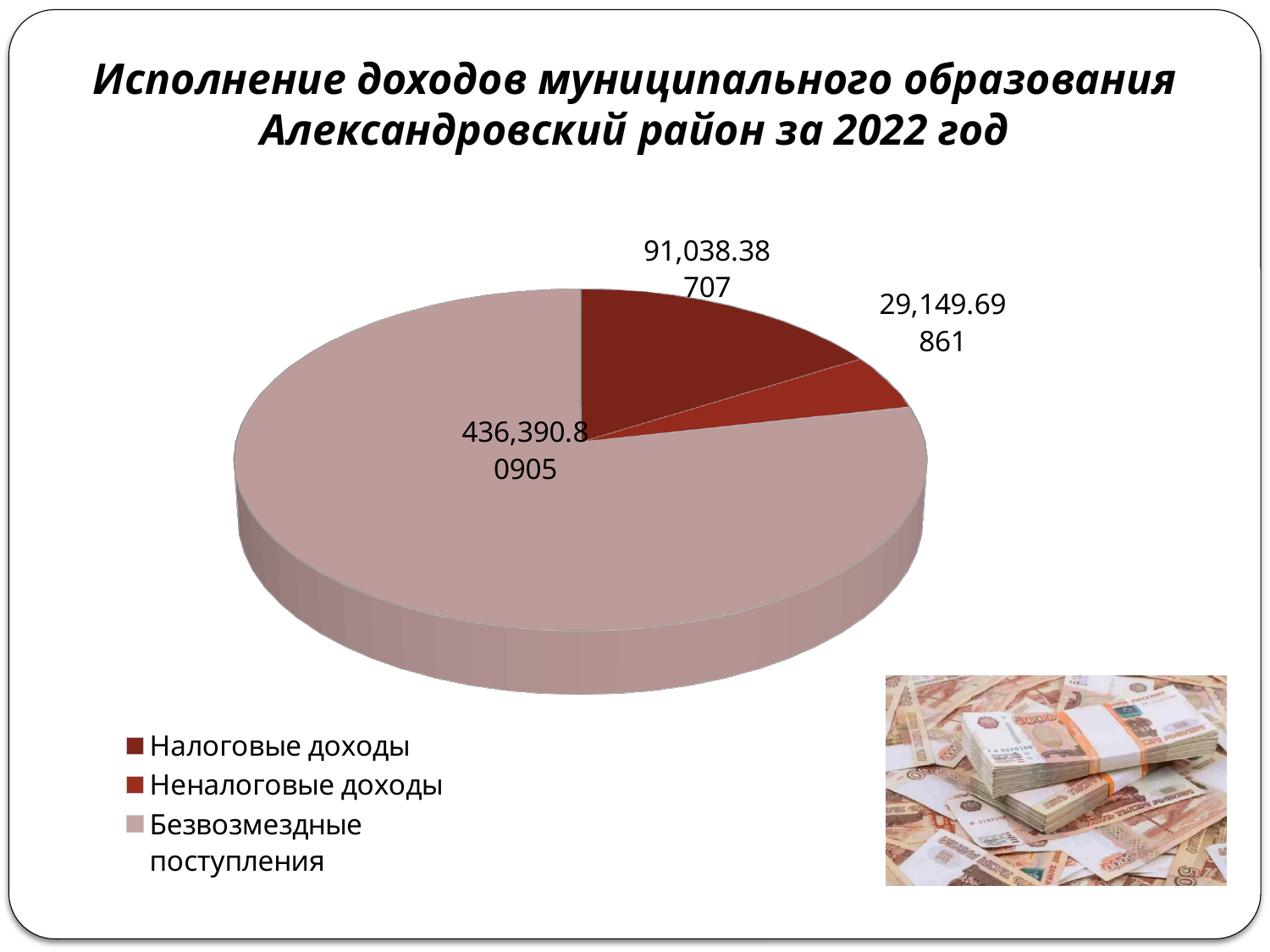
Which legend entry is listed last? Безвозмездные поступления Which is larger, Налоговые доходы or Неналоговые доходы? Налоговые доходы Which category has the largest slice of the pie? Безвозмездные поступления How many categories does the pie chart show? 3 What is the value shown for Налоговые доходы? 91,038.38707 What is the value shown for Безвозмездные поступления? 436,390.80905 What is the difference between the values for Безвозмездные поступления and Налоговые доходы? 345,352.42198 Which category has the smallest slice of the pie? Неналоговые доходы What is the difference between the values for Налоговые доходы and Неналоговые доходы? 61,888.68846 What is the value shown for Неналоговые доходы? 29,149.69861 What kind of chart is shown on the slide? Pie chart What is the title of the slide? Исполнение доходов муниципального образования Александровский район за 2022 год